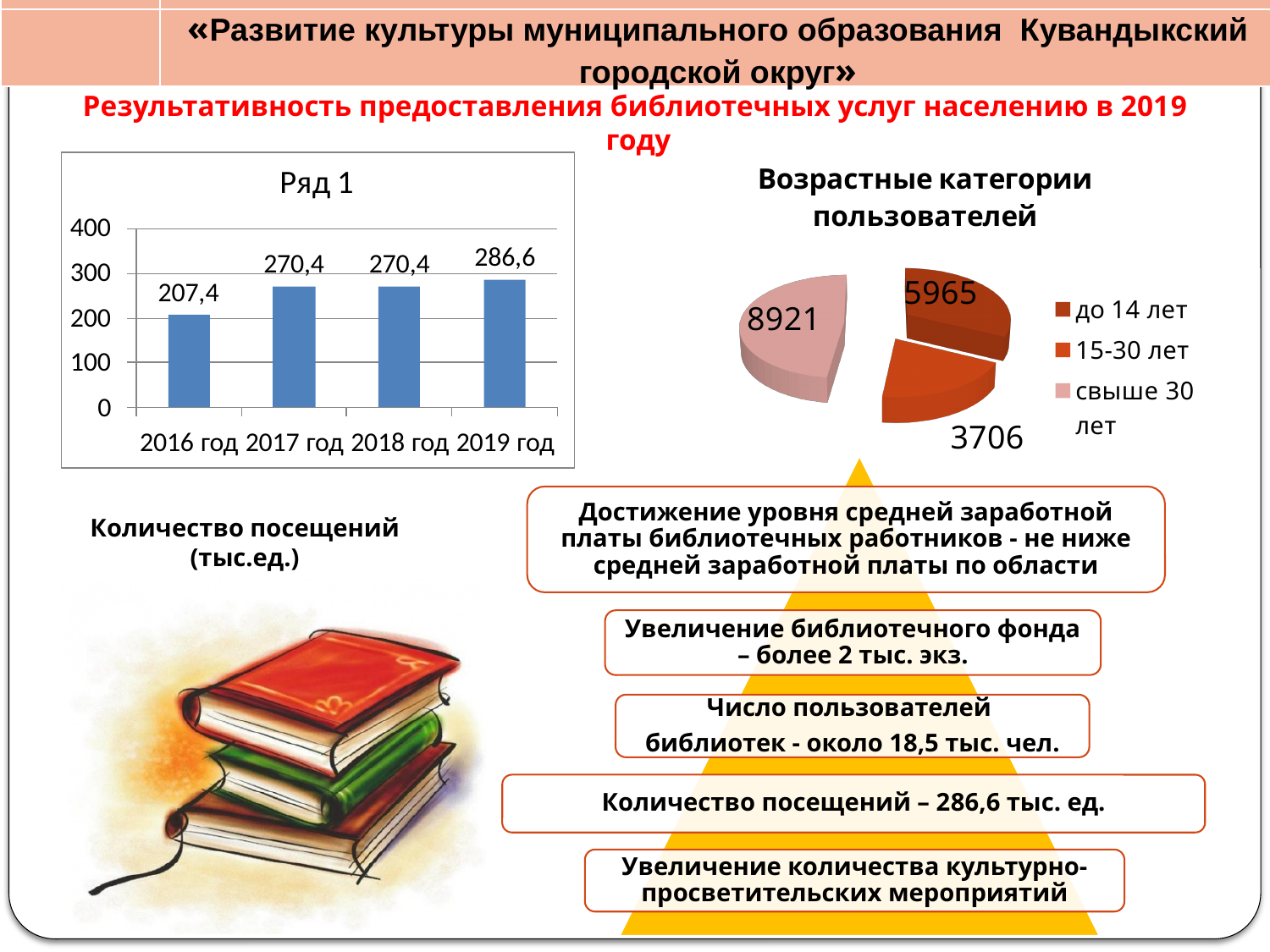
On the bar chart titled «Ряд 1», which year has the lowest value? 2016 год On the pie chart «Возрастные категории пользователей», what is the value for «15-30 лет»? 3706 On the bar chart titled «Ряд 1», what is the value for 2016 год? 207,4 On the bar chart titled «Ряд 1», which year has the highest value? 2019 год On the pie chart «Возрастные категории пользователей», what is the value for «свыше 30 лет»? 8921 On the bar chart titled «Ряд 1», do the values generally rise or fall from 2016 год to 2019 год? rise On the bar chart titled «Ряд 1», what is the value for 2019 год? 286,6 On the bar chart titled «Ряд 1», what is the difference between the values for 2019 год and 2016 год? 79,2 On the bar chart titled «Ряд 1», how many years are shown on the x axis? 4 What kind of chart is the chart titled «Ряд 1»? bar chart On the pie chart «Возрастные категории пользователей», which age category has the largest slice? свыше 30 лет How many categories does the legend of the pie chart «Возрастные категории пользователей» list? 3